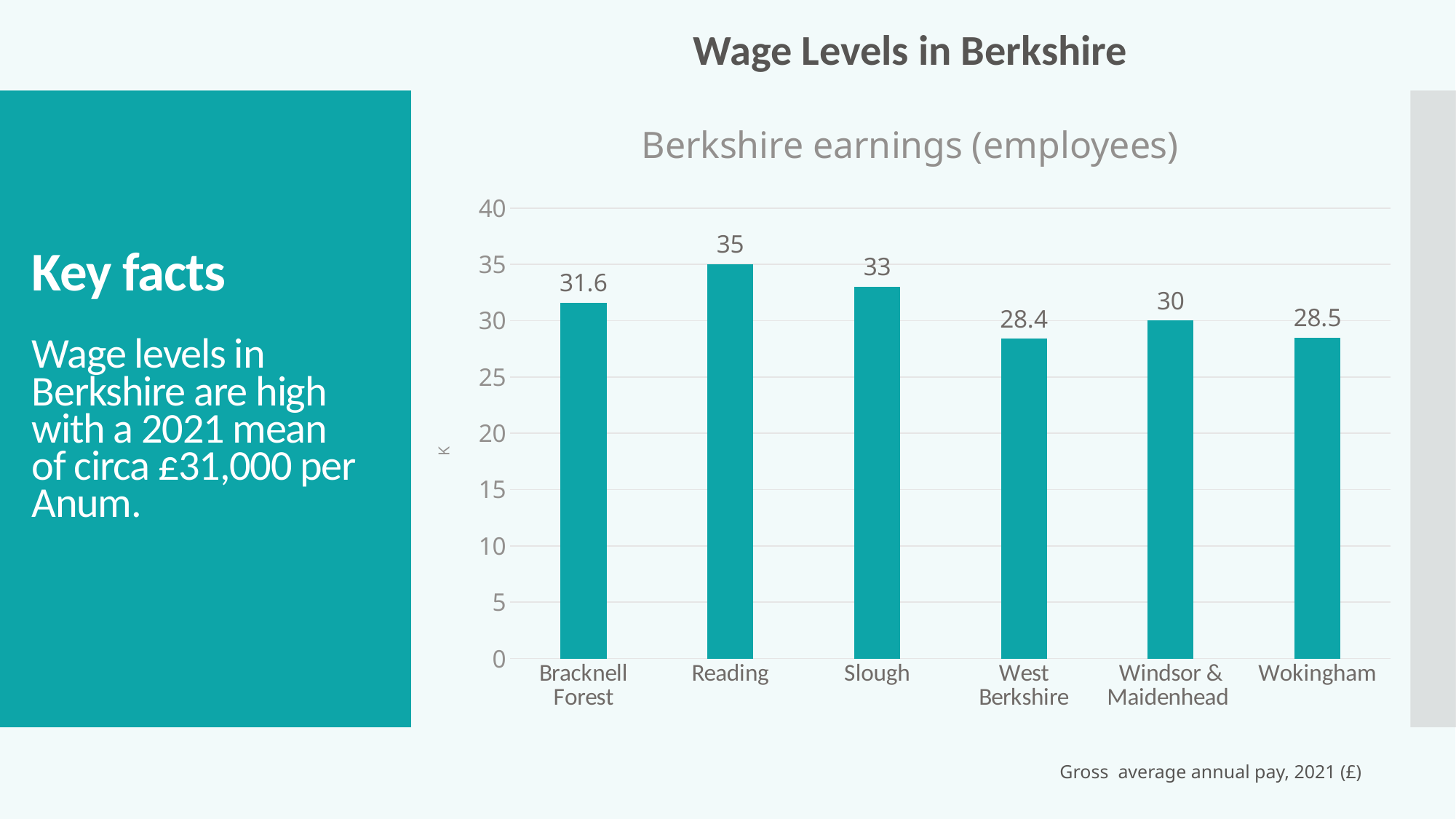
What is the value for West Berkshire? 28.4 Which is larger, the value for Slough or the value for Windsor & Maidenhead? Slough What is the value for Bracknell Forest? 31.6 What is the difference between the values for Bracknell Forest and Wokingham? 3.1 What is the title of the chart? Berkshire earnings (employees) Which area has the lowest earnings? West Berkshire Is the value for Wokingham greater or less than 30? less What is the value for Reading? 35 What is the difference between the values for Reading and Slough? 2 How many areas are shown in the chart? 6 Which area has the highest earnings? Reading What kind of chart is shown on the slide? bar chart